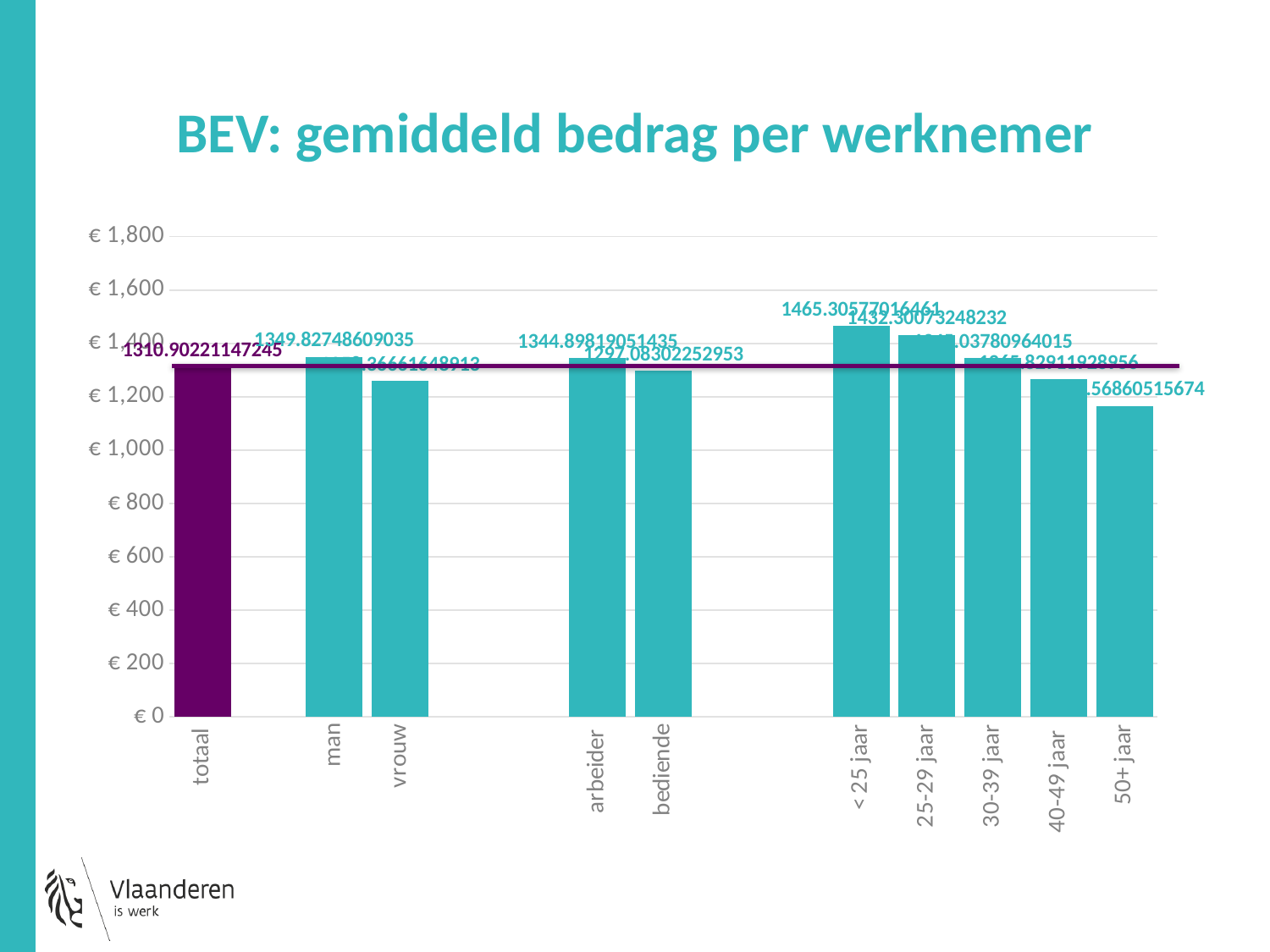
What is the value for totaal? 1310.90221147245 Which category has the lowest value? 50+ jaar What is the value for bediende? 1297.08302252953 Is the value for 50+ jaar greater or less than 1,200? less How many categories are plotted on the x axis? 10 What kind of chart is shown on the slide? bar chart Which is larger, the value for man or the value for vrouw? man What is the title of the chart? BEV: gemiddeld bedrag per werknemer What is the value for man? 1349.82748609035 What is the value for arbeider? 1344.89819051435 Which category has the highest value? < 25 jaar Do the values rise or fall across the age groups from < 25 jaar to 50+ jaar? fall